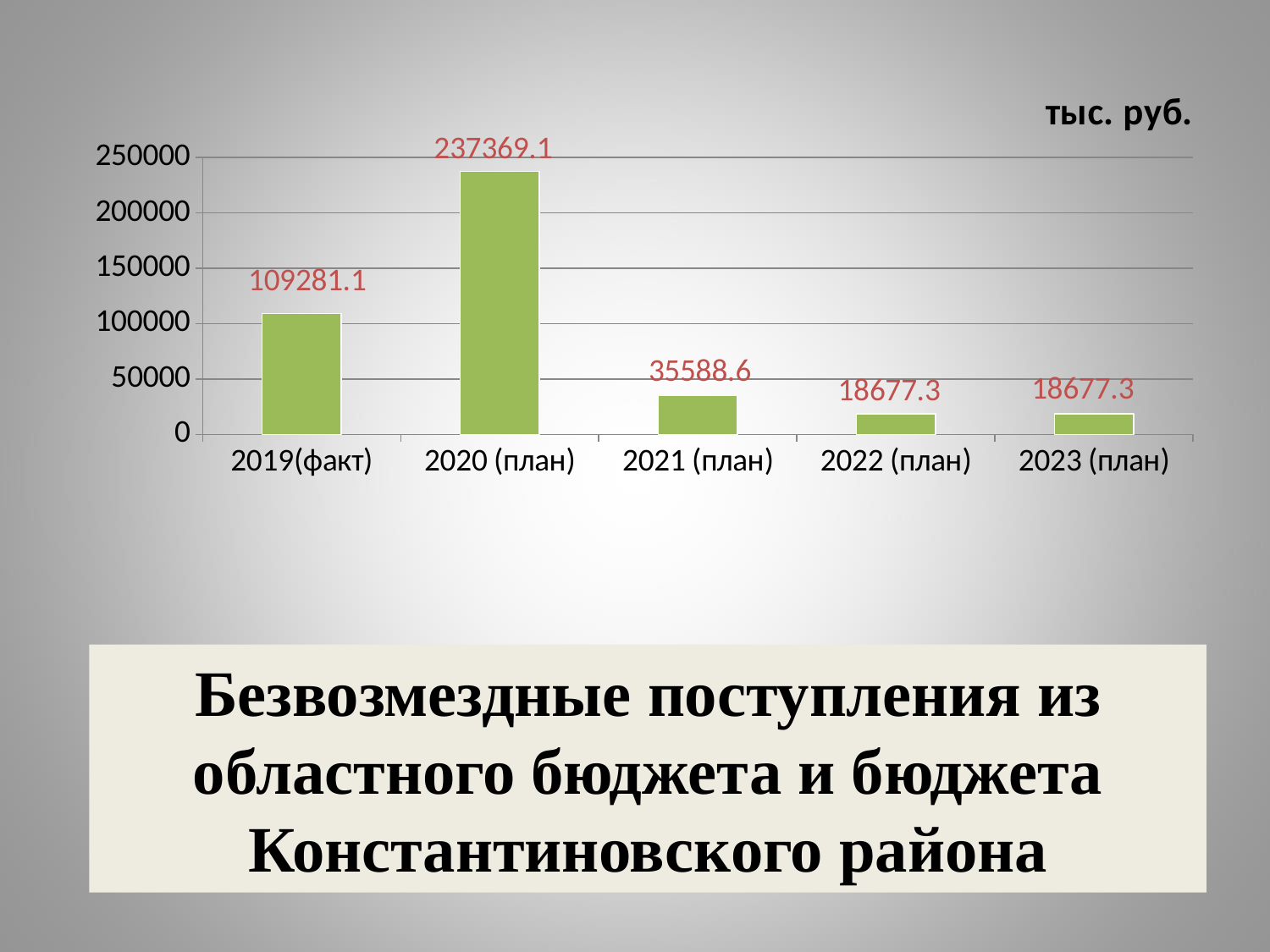
What is the value for 2019(факт)? 109281.1 From 2020 (план) to 2023 (план), do the values rise or fall? Fall What is the difference between the values for 2020 (план) and 2019(факт)? 128088 What is the value for 2023 (план)? 18677.3 What is the difference between the values for 2021 (план) and 2022 (план)? 16911.3 Are the values for 2022 (план) and 2023 (план) the same? Yes How many categories are shown on the x axis? 5 What is the value for 2021 (план)? 35588.6 Which is larger, the value for 2019(факт) or the value for 2021 (план)? 2019(факт) What is the value for 2020 (план)? 237369.1 What kind of chart is shown on the slide? Bar chart Which category has the highest value? 2020 (план)